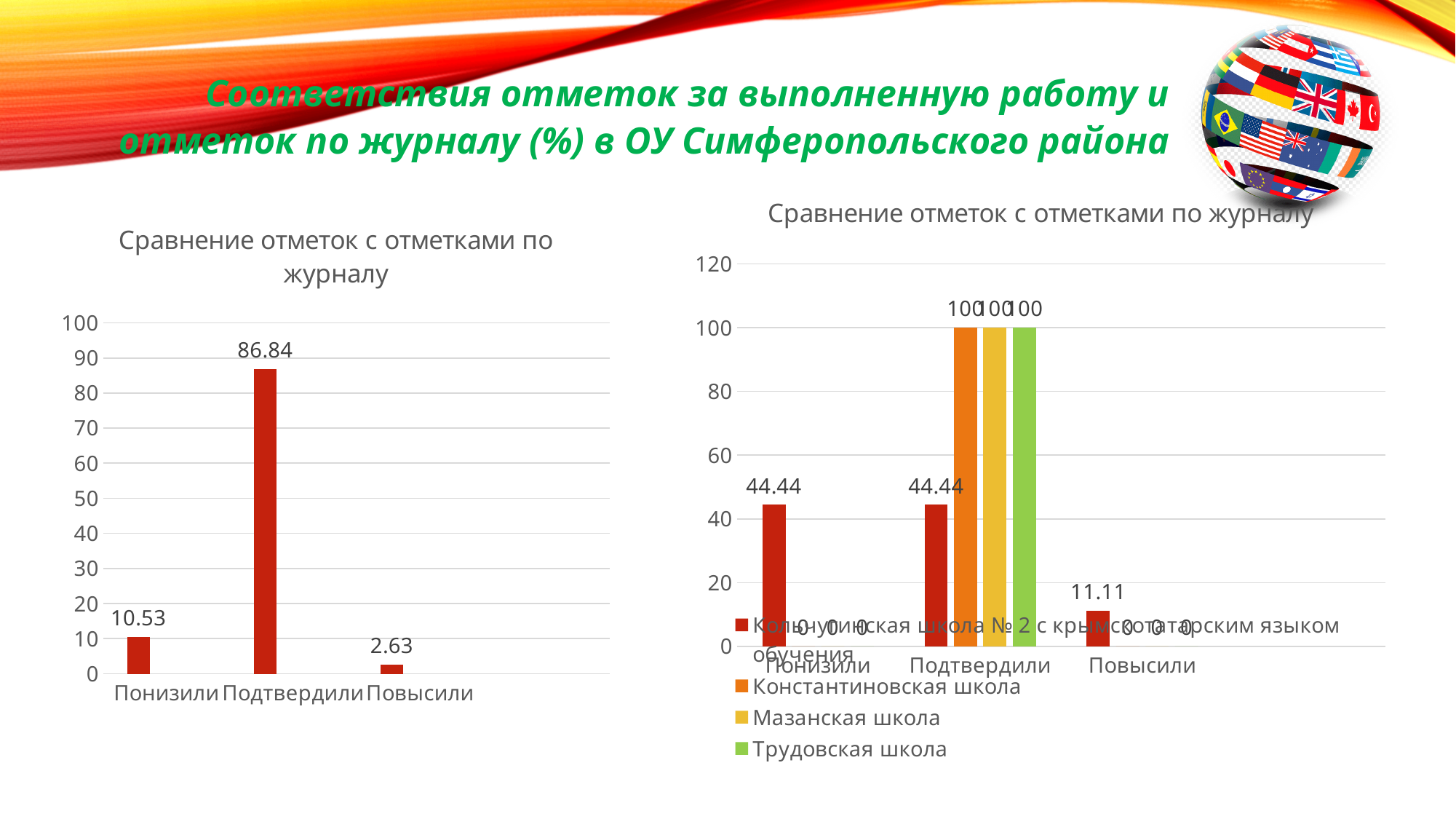
In the right chart, which colour represents Мазанская школа in the legend? yellow In the right chart, what is the value for Константиновская школа in the Подтвердили category? 100 In the left chart, what is the value for Понизили? 10.53 In the right chart, how many series does the legend list? 4 In the left chart, what is the value for Подтвердили? 86.84 In the right chart, what is the value for Кольчугинская школа № 2 с крымскотатарским языком обучения in the Повысили category? 11.11 In the left chart, what is the difference between the values for Подтвердили and Понизили? 76.31 What kind of chart is the left chart? bar chart In the left chart, which category has the lowest value? Повысили In the left chart, how many categories are shown on the x axis? 3 In the right chart, which is larger for Кольчугинская школа № 2 с крымскотатарским языком обучения: the value for Понизили or the value for Повысили? Понизили In the right chart, what is the value for Трудовская школа in the Понизили category? 0